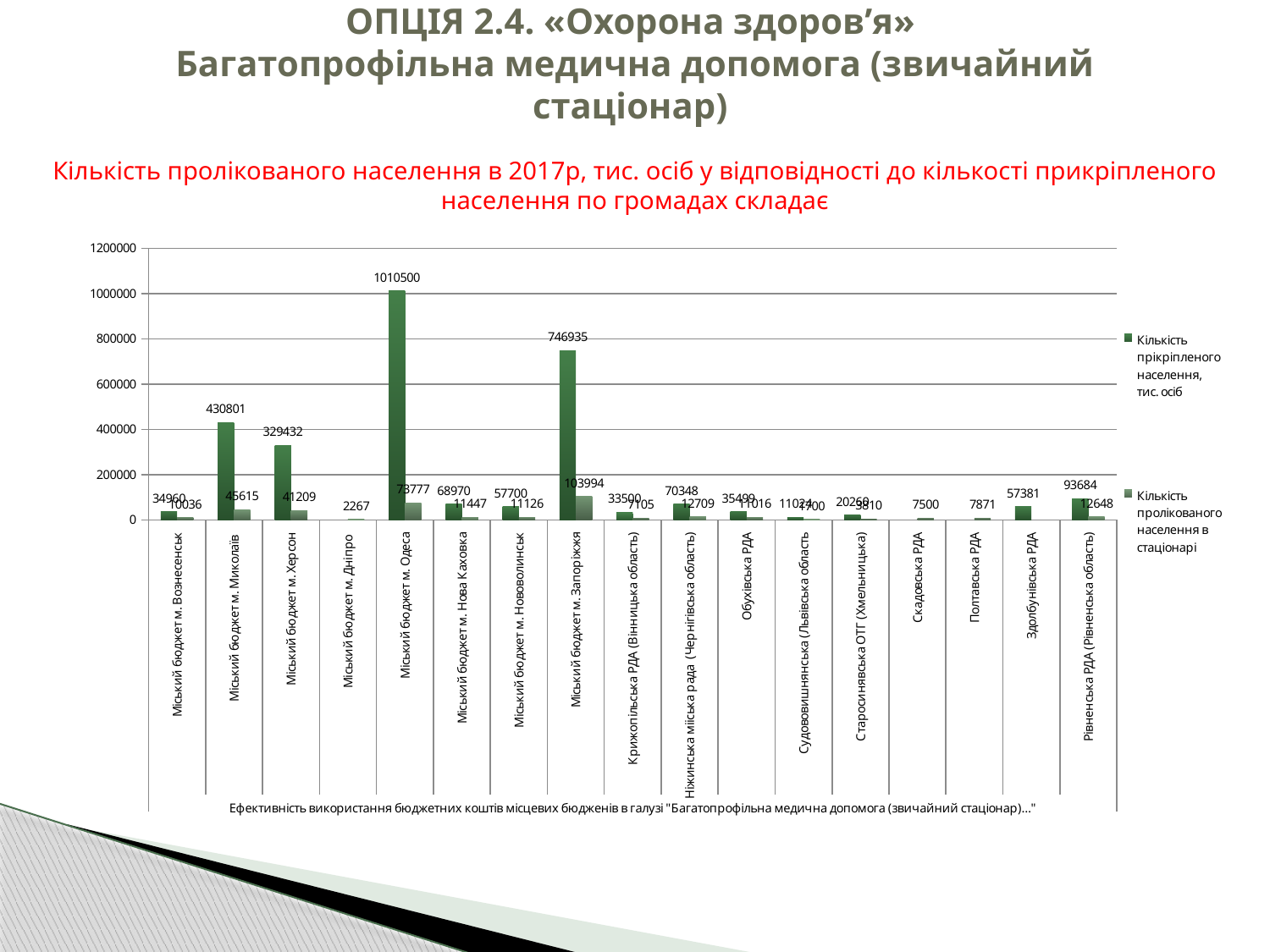
What is the difference between the 'Кількість прикріпленого населення, тис. осіб' values for Міський бюджет м. Одеса and Міський бюджет м. Запоріжжя? 263565 How many series does the legend list? 2 Which has the larger 'Кількість прикріпленого населення, тис. осіб' value: Міський бюджет м. Миколаїв or Міський бюджет м. Херсон? Міський бюджет м. Миколаїв What is the first entry listed in the chart legend? Кількість прікріпленого населення, тис. осіб How many categories are shown on the x axis of the chart? 17 What is the value of 'Кількість пролікованого населення в стаціонарі' for Міський бюджет м. Запоріжжя? 103994 Is the 'Кількість прикріпленого населення, тис. осіб' value for Міський бюджет м. Миколаїв greater or less than 400000? greater What is the value of 'Кількість пролікованого населення в стаціонарі' for Міський бюджет м. Нова Каховка? 11447 What is the value of 'Кількість прикріпленого населення, тис. осіб' for Міський бюджет м. Одеса? 1010500 What is the value of 'Кількість прикріпленого населення, тис. осіб' for Рівненська РДА (Рівненська область)? 93684 What type of chart is shown on the slide? bar chart Which category has the highest value for 'Кількість прикріпленого населення, тис. осіб'? Міський бюджет м. Одеса